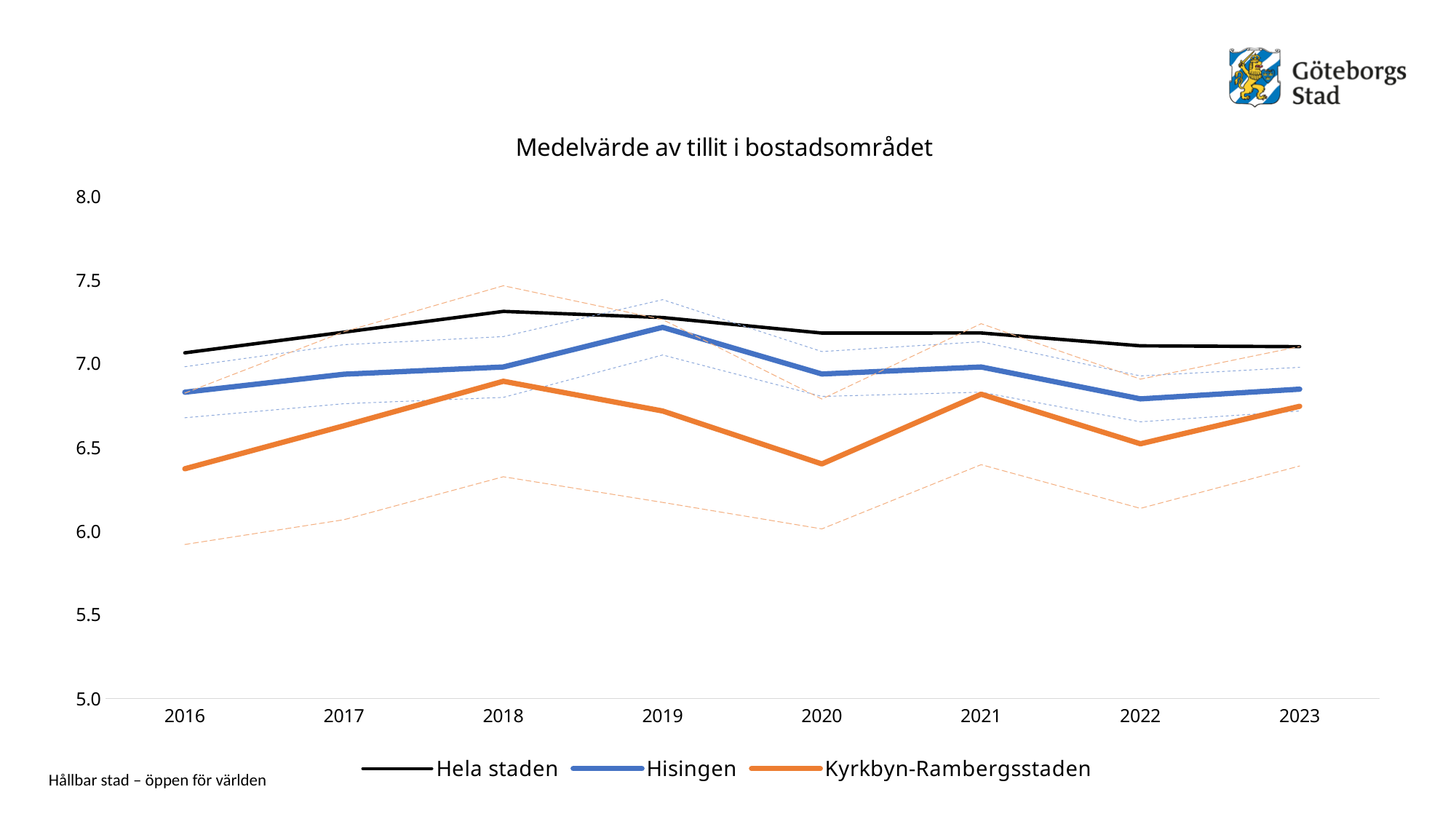
Which year has the highest value for Hisingen? 2019 What kind of chart is shown on the slide? line chart In 2016, which is higher: Hela staden or Kyrkbyn-Rambergsstaden? Hela staden Is the value for Kyrkbyn-Rambergsstaden in 2016 greater or less than 6.5? less Does the value for Kyrkbyn-Rambergsstaden rise or fall from 2016 to 2018? rise What colour is the line for Hisingen? blue How many series does the legend list? 3 Is the value for Hisingen in 2022 greater or less than 7.0? less How many years are shown on the x axis? 8 What is the title of the chart? Medelvärde av tillit i bostadsområdet Is the value for Hela staden in 2018 greater or less than 7.0? greater